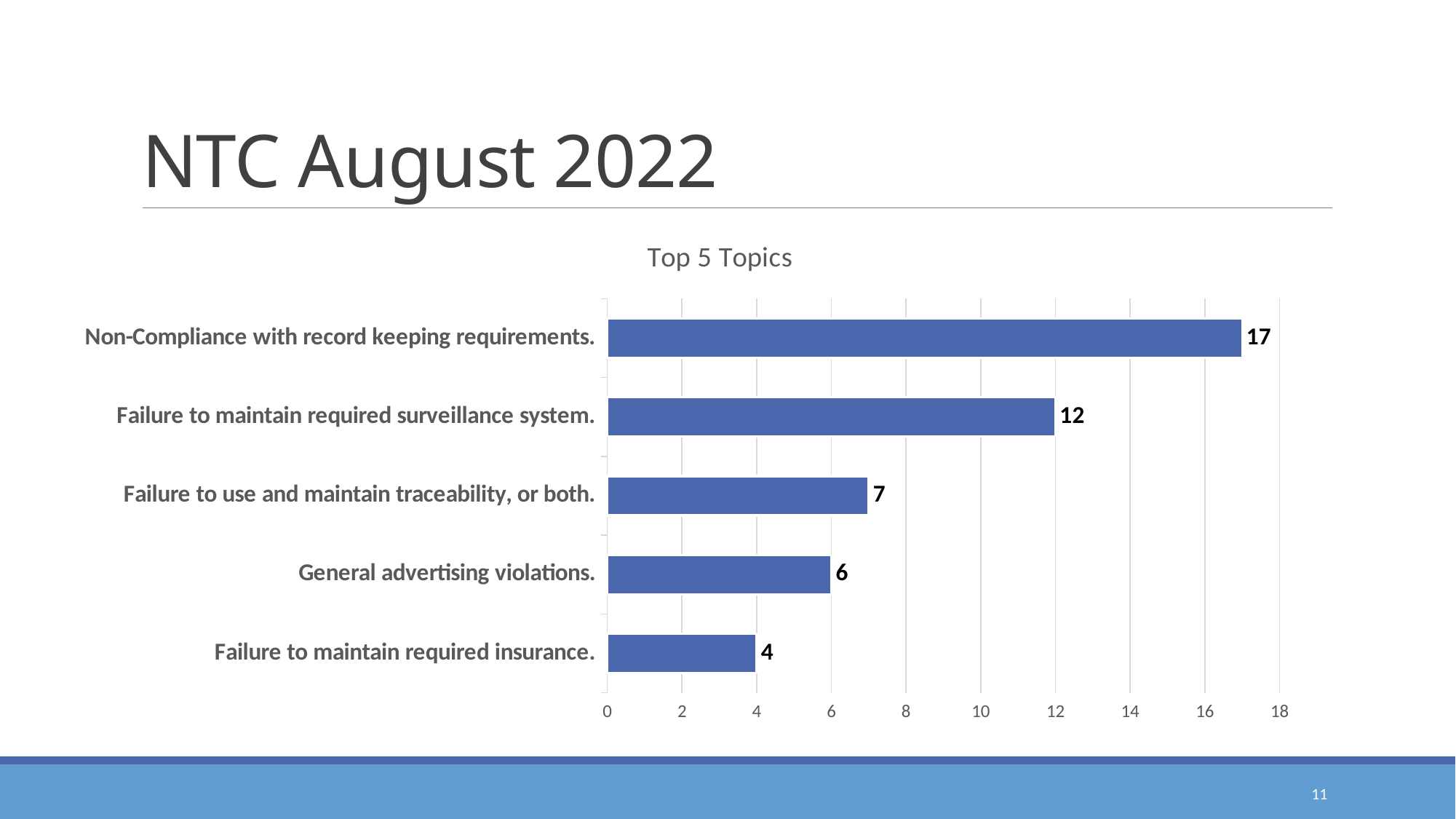
Which category has the highest value? Non-Compliance with record keeping requirements. What is the value for "General advertising violations."? 6 What is the title of the chart? Top 5 Topics Which is larger, the value for "Failure to use and maintain traceability, or both." or the value for "General advertising violations."? Failure to use and maintain traceability, or both. What is the value for "Failure to maintain required surveillance system."? 12 How many categories are shown in the chart? 5 What kind of chart is shown on the slide? bar chart What is the value for "Non-Compliance with record keeping requirements."? 17 Is the value for "Failure to maintain required surveillance system." greater or less than 10? greater Which category has the lowest value? Failure to maintain required insurance. What is the difference between the values for "Non-Compliance with record keeping requirements." and "Failure to maintain required surveillance system."? 5 What is the difference between the values for "Failure to use and maintain traceability, or both." and "Failure to maintain required insurance."? 3